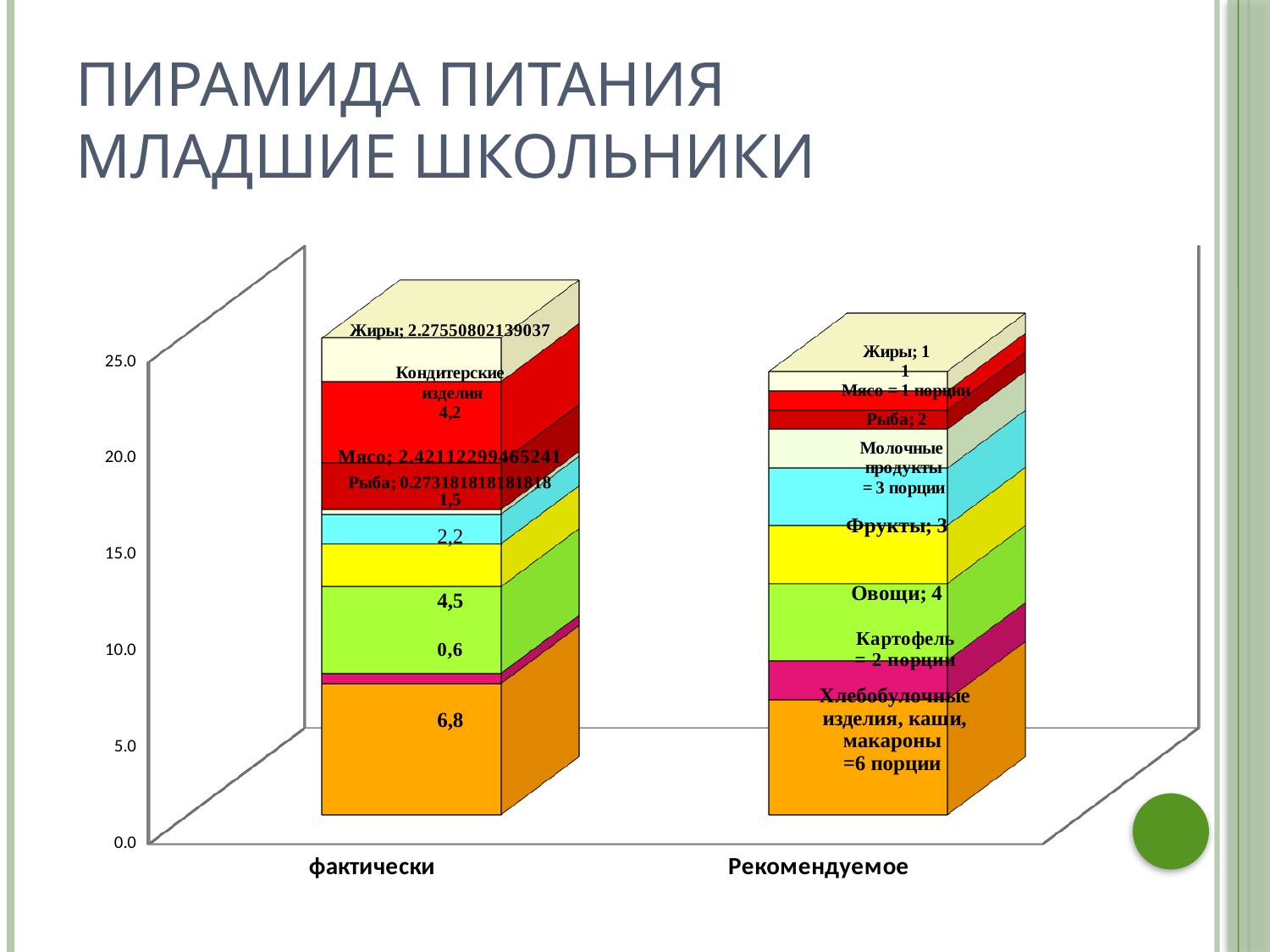
What is the value of the bottom (orange) segment of the 'фактически' bar? 6,8 How many portions of 'Хлебобулочные изделия, каши, макароны' are shown in the 'Рекомендуемое' bar? 6 порции What are the two category labels on the x axis? фактически and Рекомендуемое What value is printed for 'Рыба' in the 'Рекомендуемое' bar? 2 What kind of chart is shown on the slide? stacked bar chart What value is printed for 'Фрукты' in the 'Рекомендуемое' bar? 3 In the 'Рекомендуемое' bar, what is the difference between the values for 'Овощи' and 'Фрукты'? 1 What value is printed for 'Овощи' in the 'Рекомендуемое' bar? 4 Is the total height of the 'Рекомендуемое' bar greater or less than 20? greater What value is printed for 'Кондитерские изделия' in the 'фактически' bar? 4,2 How many bars (categories) are plotted on the x axis? 2